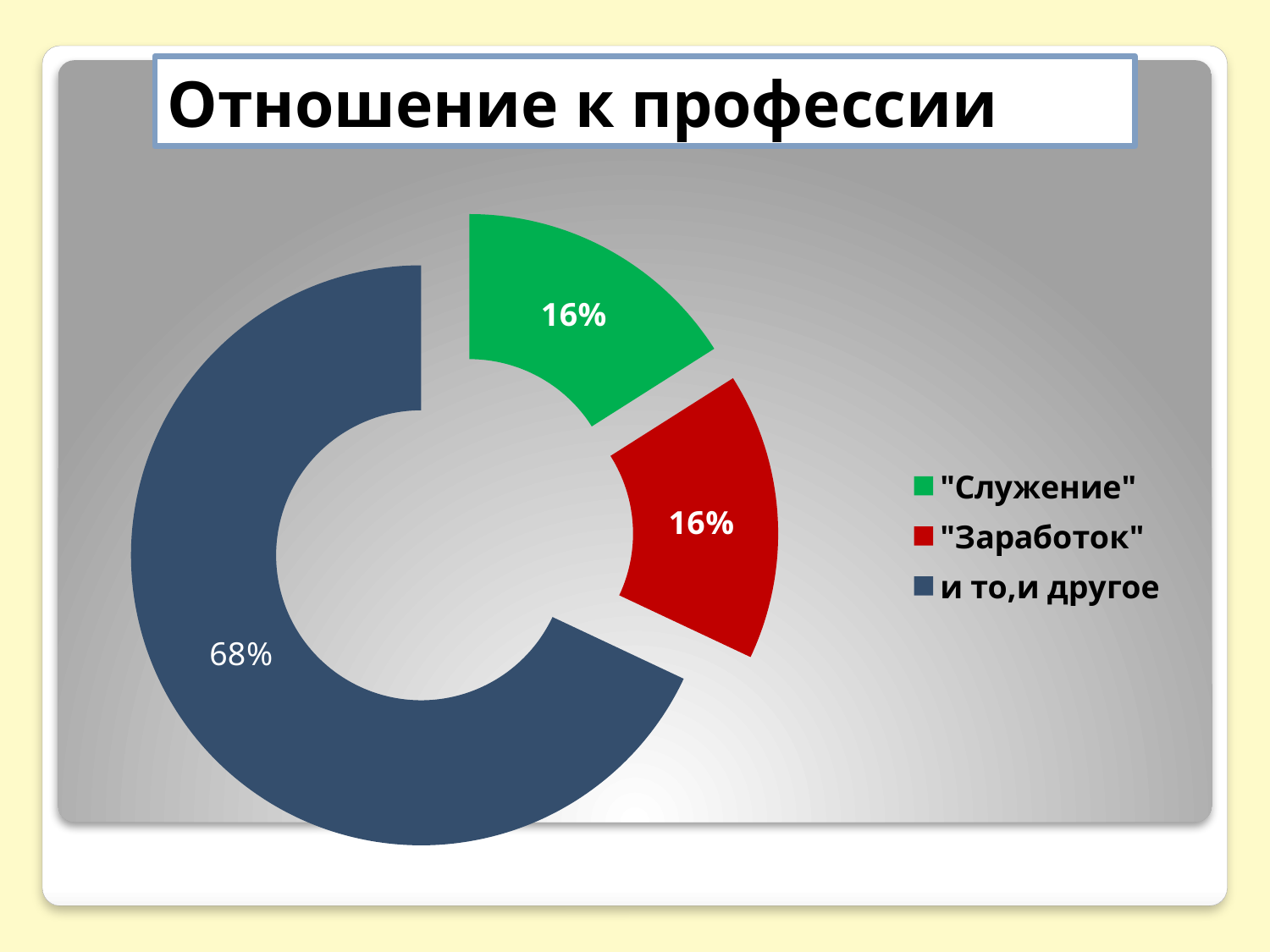
What is the title of the slide? Отношение к профессии How many entries does the legend list? 3 Which is larger, the share for "и то,и другое" or the share for "Заработок"? и то,и другое Which category has the largest share? и то,и другое What kind of chart is shown on the slide? Doughnut chart What is the value shown for "Заработок"? 16% What is the difference between the share for "и то,и другое" and the share for "Служение"? 52% What colour is the segment for "Заработок"? Red What share of the chart does "и то,и другое" represent? 68% What is the combined share of "Служение" and "Заработок"? 32% What is the value shown for "Служение"? 16% How many categories does the chart show? 3